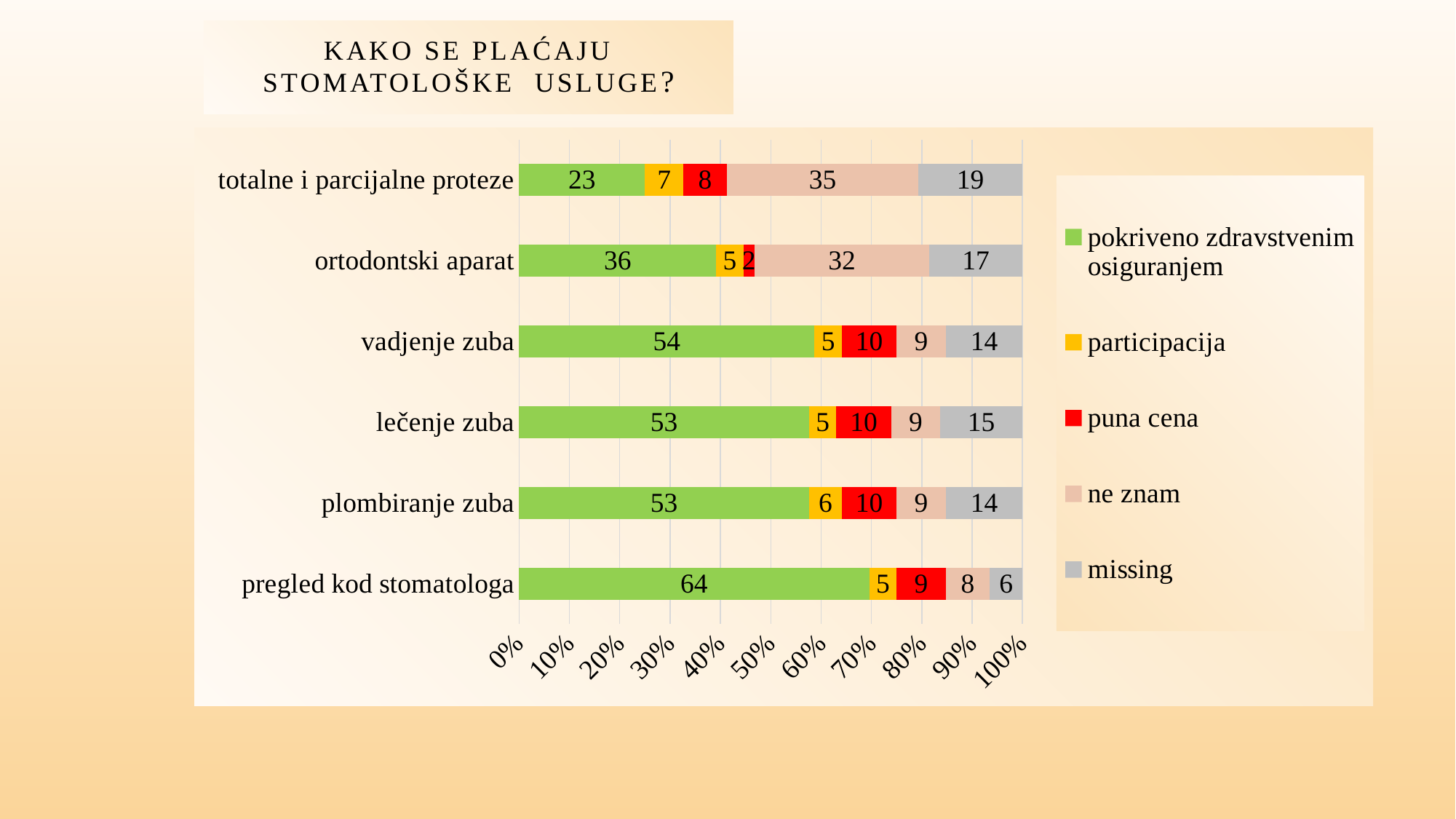
Which is larger: the 'participacija' value for 'totalne i parcijalne proteze' or for 'plombiranje zuba'? totalne i parcijalne proteze What is the value for 'pokriveno zdravstvenim osiguranjem' for 'pregled kod stomatologa'? 64 Which category has the lowest 'missing' value? pregled kod stomatologa How many categories are shown on the chart? 6 Which category has the highest 'pokriveno zdravstvenim osiguranjem' value? pregled kod stomatologa What is the 'ne znam' value for 'totalne i parcijalne proteze'? 35 What kind of chart is shown on the slide? stacked bar chart How many series does the legend list? 5 What is the 'missing' value for 'ortodontski aparat'? 17 What is the difference between the 'ne znam' values for 'totalne i parcijalne proteze' and 'ortodontski aparat'? 3 What is the 'puna cena' value for 'vadjenje zuba'? 10 Which category has the lowest 'pokriveno zdravstvenim osiguranjem' value? totalne i parcijalne proteze